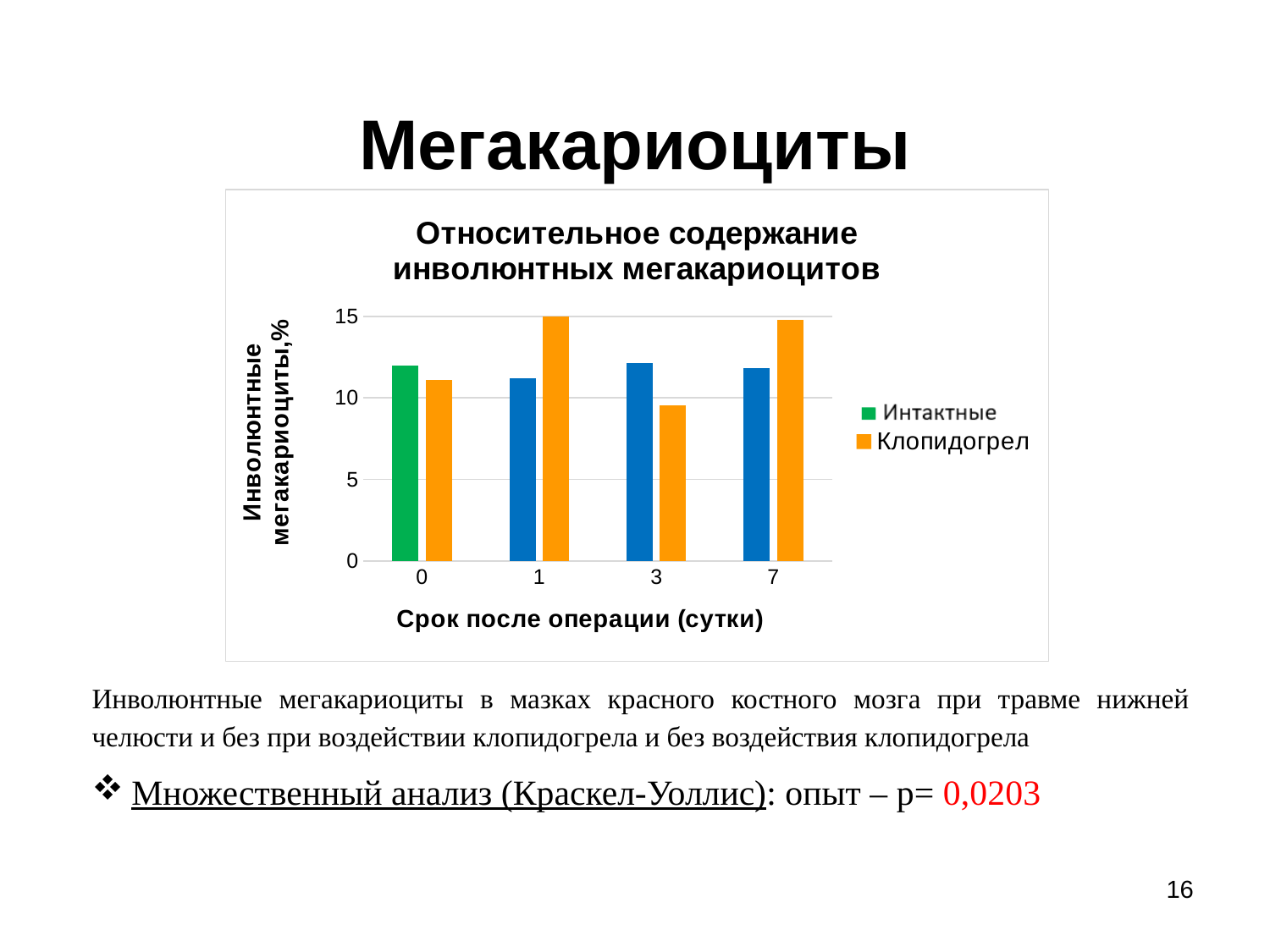
Is the value for Клопидогрел at day 1 greater or less than 10? greater Is the value for Клопидогрел at day 7 greater or less than 10? greater How many categories are shown on the x axis? 4 Which is larger for Клопидогрел: the value at day 1 or at day 3? day 1 What kind of chart is shown on the slide? bar chart At which day is the Клопидогрел value lowest? 3 What is the label of the x axis? Срок после операции (сутки) How many series does the legend list? 2 At day 0, which is larger: Интактные or Клопидогрел? Интактные What is the title of the chart? Относительное содержание инволюнтных мегакариоцитов Is the value for Интактные at day 0 greater or less than 10? greater